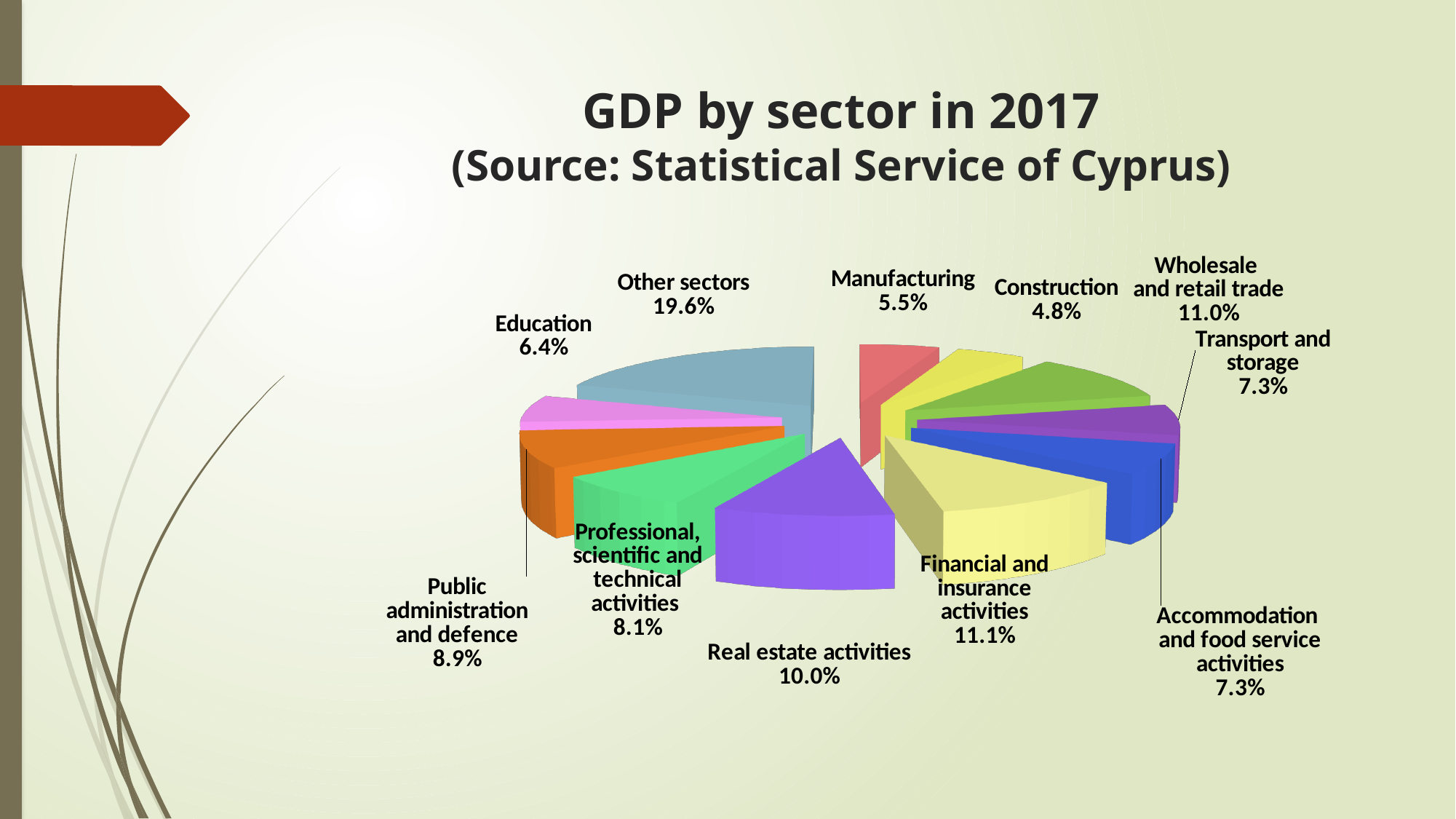
Which sector has the smallest share of GDP? Construction What is the value for Real estate activities? 10.0% What is the difference between the share of Other sectors and the share of Construction? 14.8% Which is larger, the share for Real estate activities or the share for Education? Real estate activities Which sector has the largest share of GDP? Other sectors How many sectors (slices) are shown in the pie chart? 11 What share of GDP does Manufacturing account for? 5.5% What type of chart is shown on the slide? Pie chart What percentage is shown for Public administration and defence? 8.9% What is the value shown for Financial and insurance activities? 11.1% What is the title of the chart? GDP by sector in 2017 (Source: Statistical Service of Cyprus) What is the difference between the share of Wholesale and retail trade and the share of Transport and storage? 3.7%